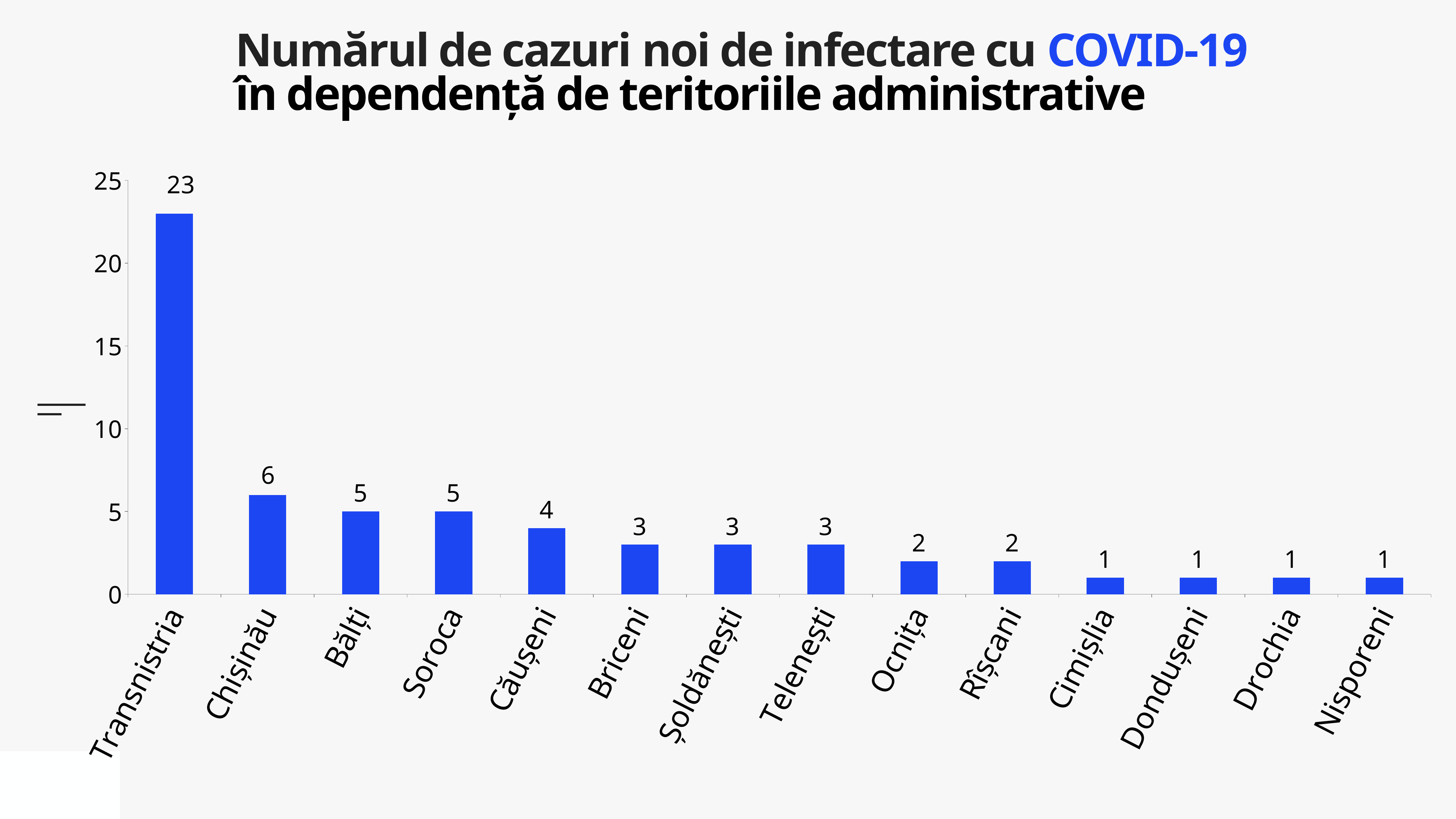
What is the value for Transnistria? 23 What is the value for Chișinău? 6 What is the difference between the values for Transnistria and Chișinău? 17 Is the value for Transnistria greater or less than 20? greater What is the value for Ocnița? 2 Which is larger, the value for Soroca or the value for Telenești? Soroca Do the values rise or fall from left to right along the x axis? fall How many categories are shown on the x axis? 14 What is the difference between the values for Bălți and Briceni? 2 What is the value for Căușeni? 4 Which category has the highest value? Transnistria What kind of chart is shown on the slide? bar chart